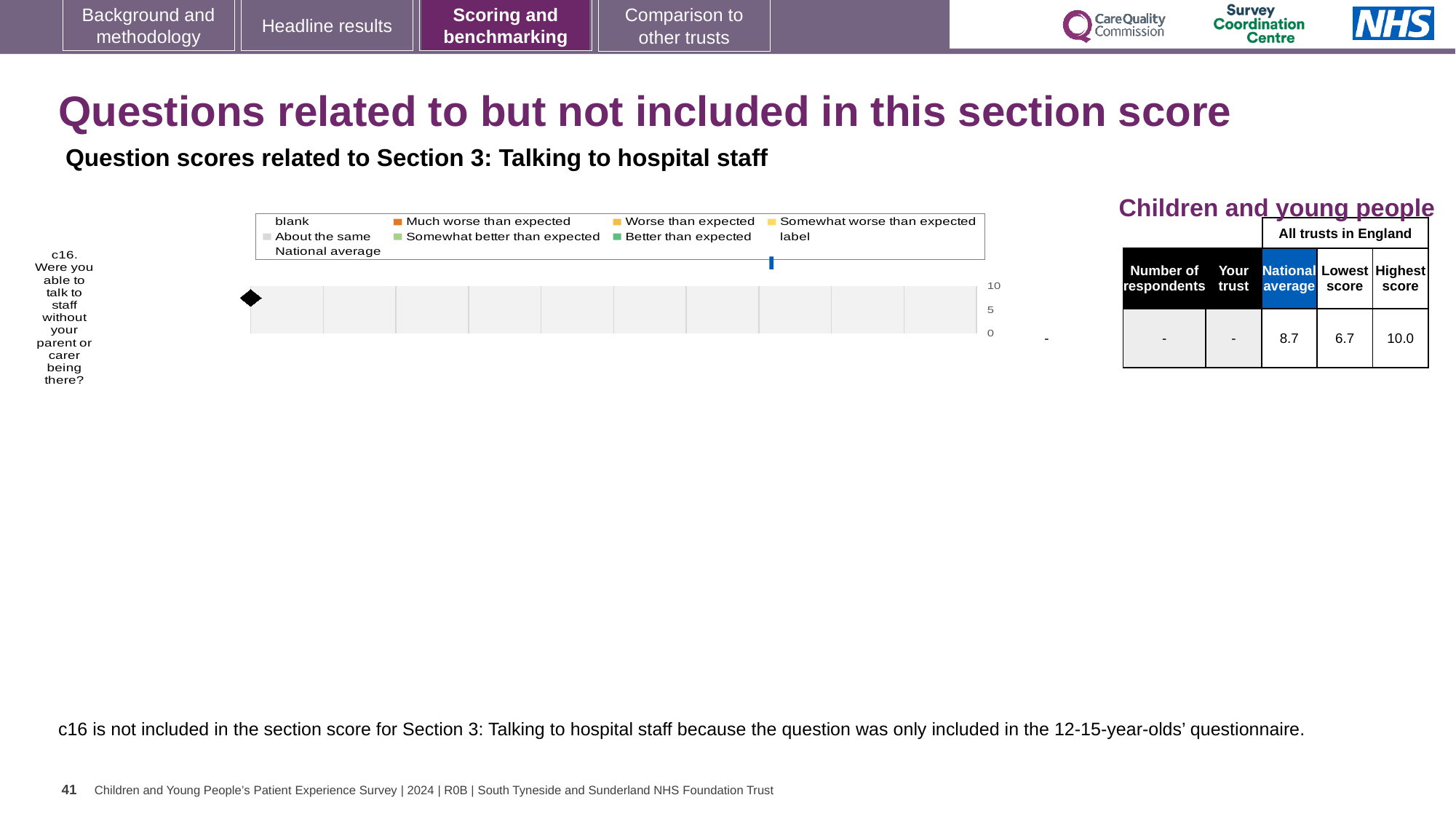
What is the subtitle above the chart? Question scores related to Section 3: Talking to hospital staff What kind of chart is shown on the slide? bar chart What data label is shown at the right end of the c16 row on the chart? - How many questions (categories) are plotted on the chart? 1 What is the highest value shown on the chart's axis? 10 How many entries does the chart legend list? 9 Which question is plotted on the chart? c16. Were you able to talk to staff without your parent or carer being there?